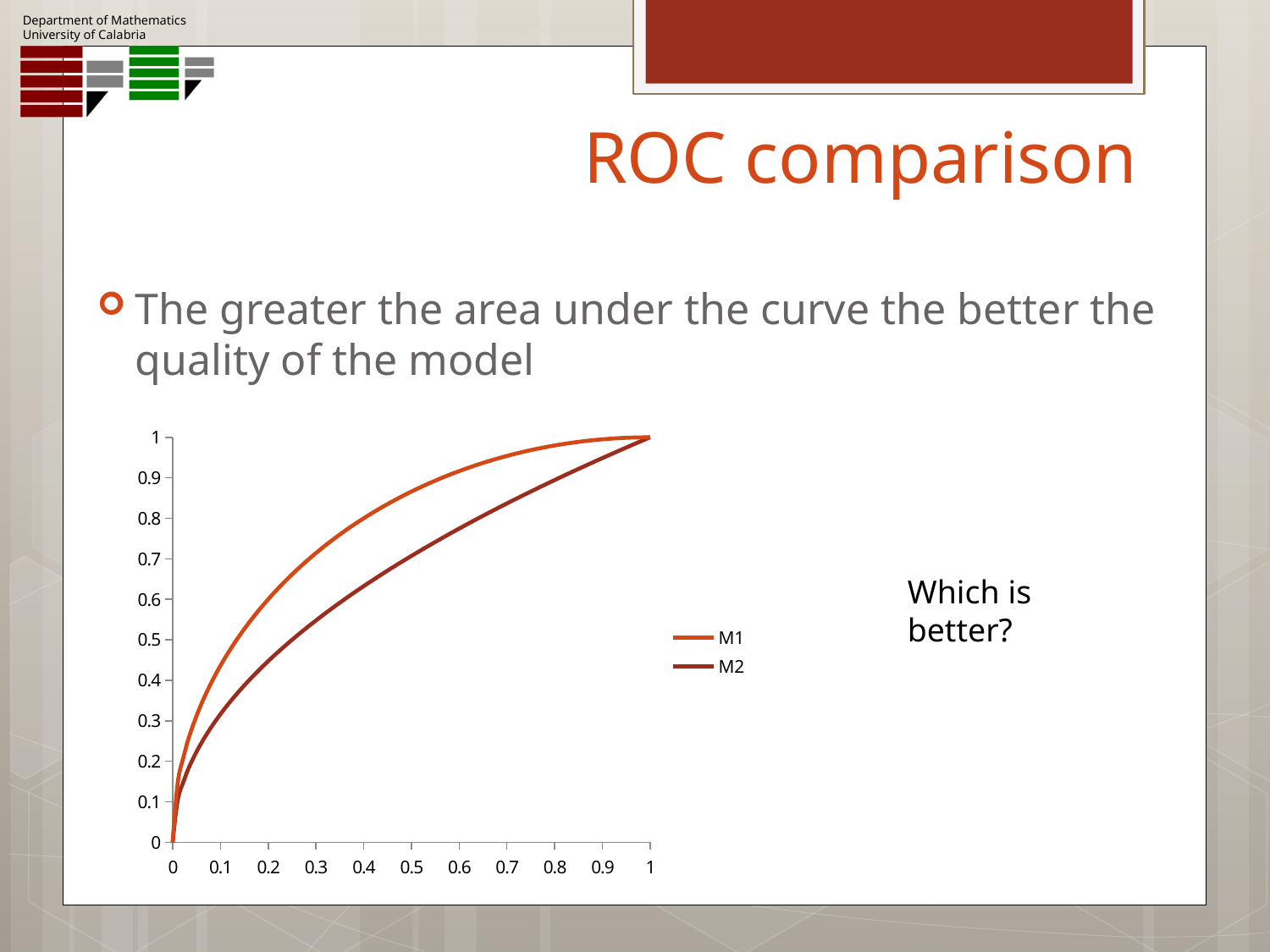
Which series is drawn in the lighter orange colour? M1 At x = 0.5, which series has the larger value, M1 or M2? M1 Is the value of M2 at x = 0.5 greater or less than 0.8? less Is the value of M2 at x = 0.2 greater or less than 0.6? less What are the names of the two series in the legend? M1 and M2 How many series does the chart's legend list? 2 What is the value of M2 at x = 1? 1 Do the values of the M1 curve rise or fall as x increases from 0 to 1? rise Do the values of the M2 curve rise or fall as x increases from 0 to 1? rise What kind of chart is shown on the slide? line chart Is the value of M1 at x = 0.5 greater or less than 0.7? greater What is the value of M1 at x = 1? 1